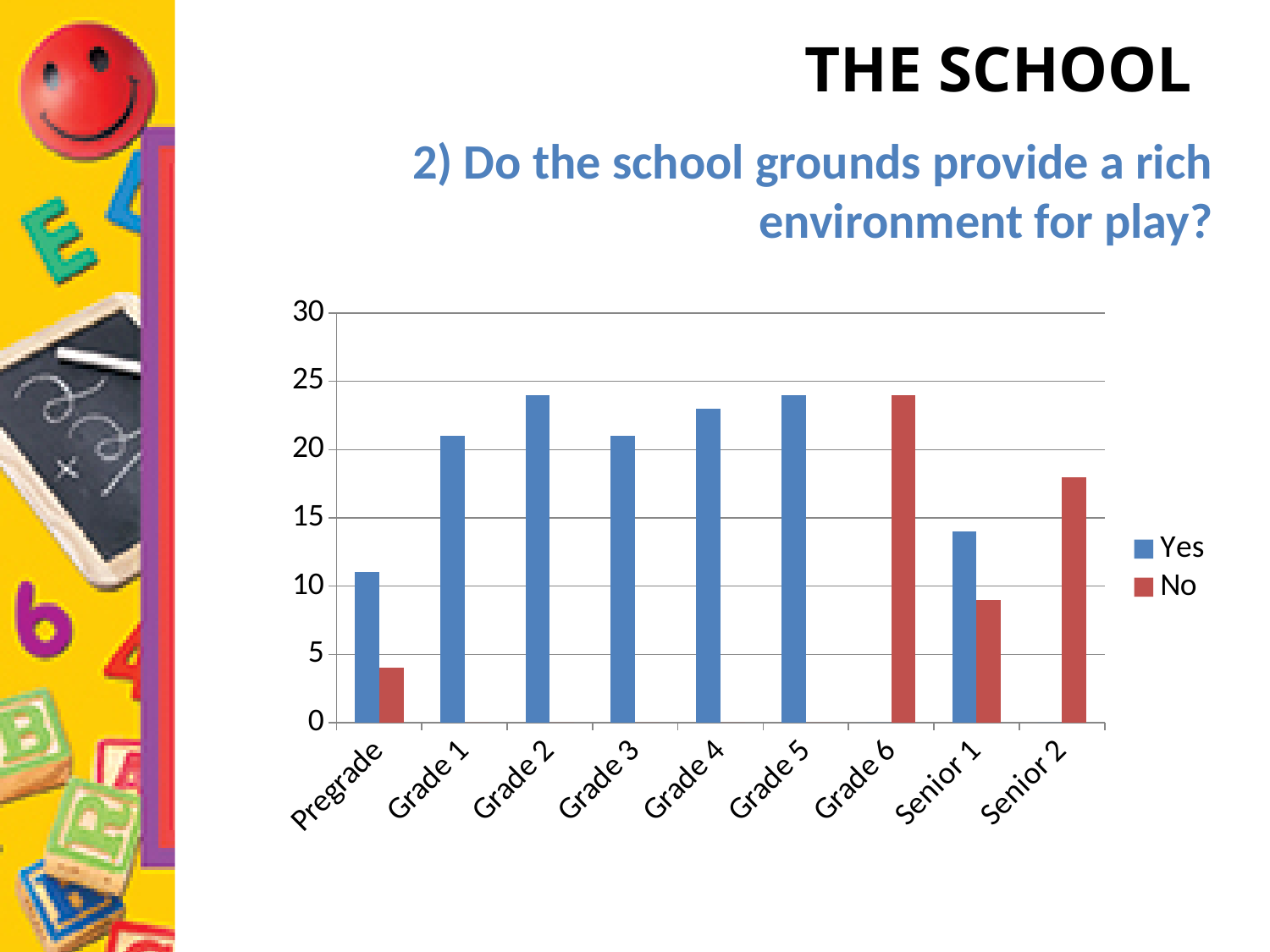
How many categories are shown on the x axis? 9 Which is larger, the No value for Senior 2 or the No value for Senior 1? Senior 2 Is the Yes value for Pregrade greater or less than 15? less Is the No value for Senior 2 greater or less than 20? less How many series does the legend list? 2 Is the No value for Grade 6 greater or less than 20? greater What kind of chart is shown on the slide? bar chart What are the two legend entries of the chart? Yes and No Which category has the lowest No value among those with a No bar? Pregrade Which is larger for Senior 1, the Yes value or the No value? Yes Which category has the highest No value? Grade 6